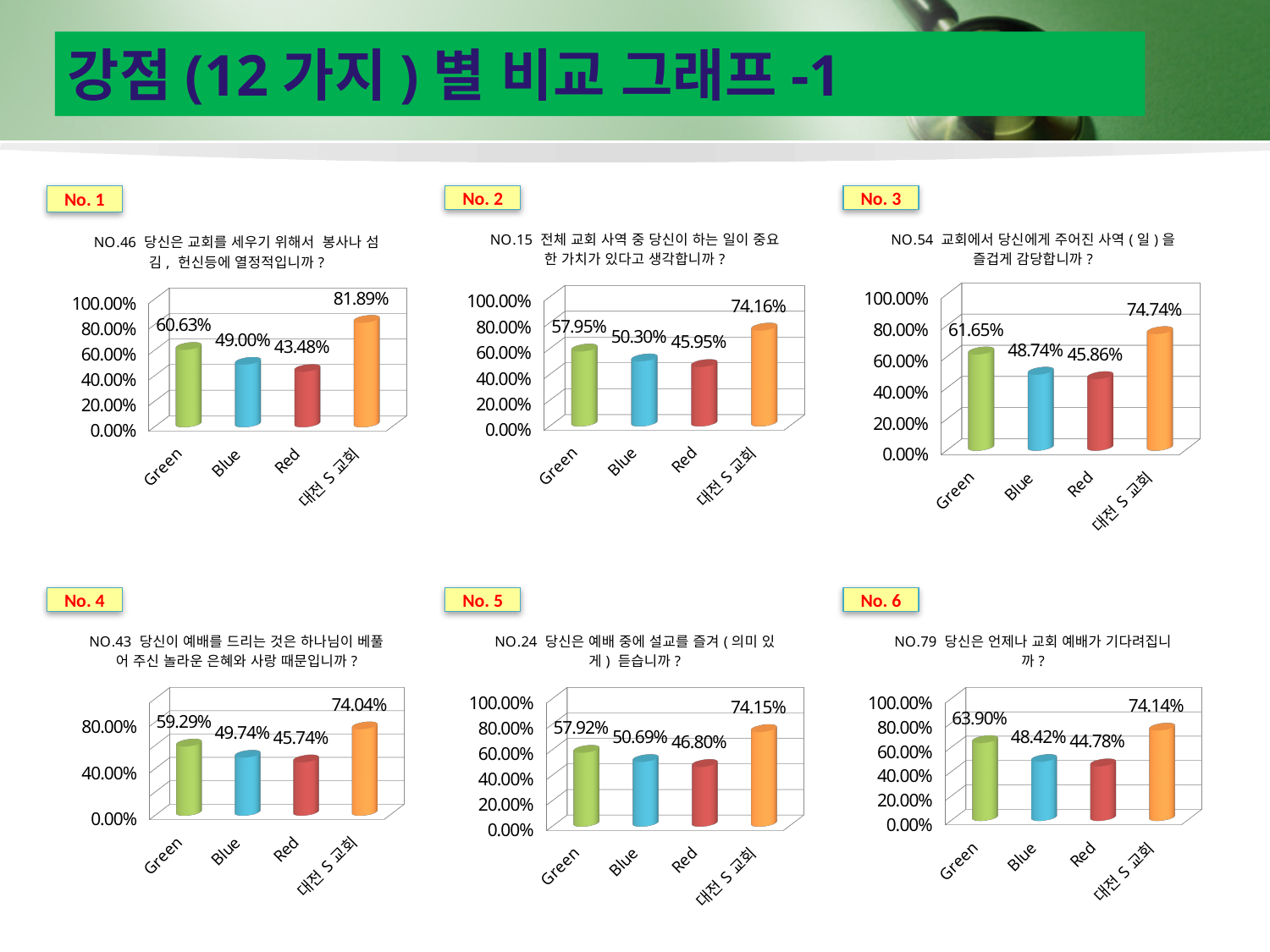
In the No. 4 chart, which category has the highest value? 대전 S 교회 What kind of chart is the No. 6 chart? bar chart In the No. 5 chart, what is the value for Green? 57.92% In the No. 3 chart, is the value for Blue greater or less than 60.00%? less In the No. 6 chart, what is the difference between the Green and Red values? 19.12% How many charts are shown on the slide? 6 How many categories are shown in the No. 5 chart? 4 In the No. 2 chart, which is larger, the value for Green or the value for Red? Green In the No. 1 chart, what is the difference between the 대전 S 교회 and Green values? 21.26% In the No. 3 chart, which category has the lowest value? Red In the No. 1 chart, what is the value for 대전 S 교회? 81.89% In the No. 2 chart, what is the value for Blue? 50.30%